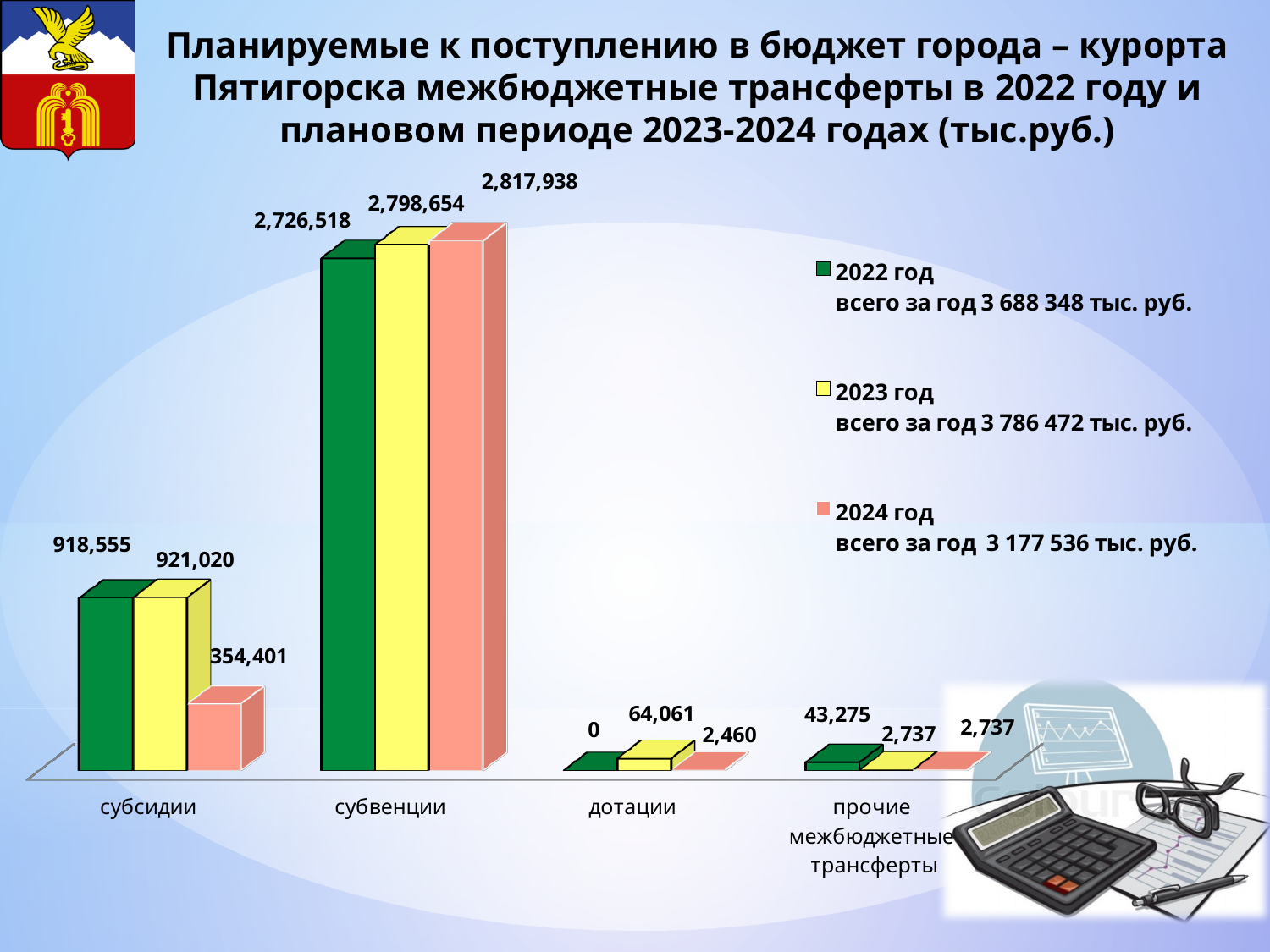
What is the difference between the 2023 год and 2022 год values for субсидии? 2,465 According to the legend, what is the total for 2023 год? 3 786 472 тыс. руб. What is the value for субсидии in 2024 год? 354,401 Which category has the highest value in 2024 год? субвенции Which category has the lowest value in 2022 год? дотации Which is larger for субвенции: the 2023 год value or the 2024 год value? 2024 год What is the value for дотации in 2023 год? 64,061 What is the value for субвенции in 2022 год? 2,726,518 How many series does the legend list? 3 What is the value for прочие межбюджетные трансферты in 2022 год? 43,275 How many categories are shown on the x axis? 4 What kind of chart is shown on the slide? bar chart